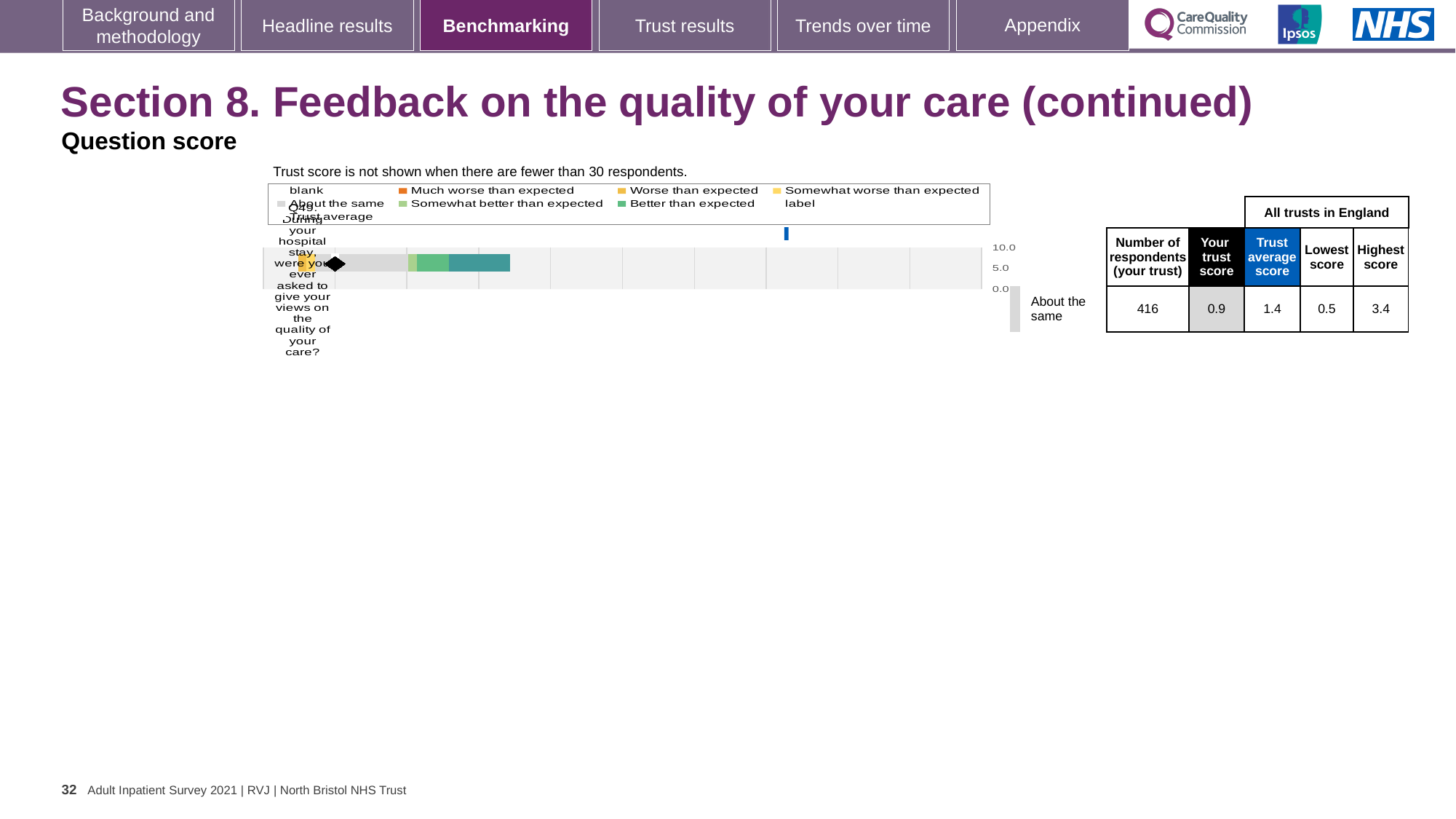
What is the trust average score for Q49 shown in the table next to the chart? 1.4 What kind of chart is used to show the Q49 question score? bar chart How many respondents from the trust answered Q49? 416 Is the trust score for Q49 greater or less than 5.0 on the chart axis? less What is the trust score for Q49 shown in the table next to the chart? 0.9 Which is larger for Q49: the trust score or the trust average score? Trust average score What is the difference between the trust average score and the trust score for Q49? 0.5 What is the lowest score across all trusts in England for Q49? 0.5 How many questions are plotted on the chart? 1 What is the difference between the highest score and the lowest score for Q49? 2.9 What is the highest score across all trusts in England for Q49? 3.4 Which benchmark category is shown for Q49 on the chart? About the same